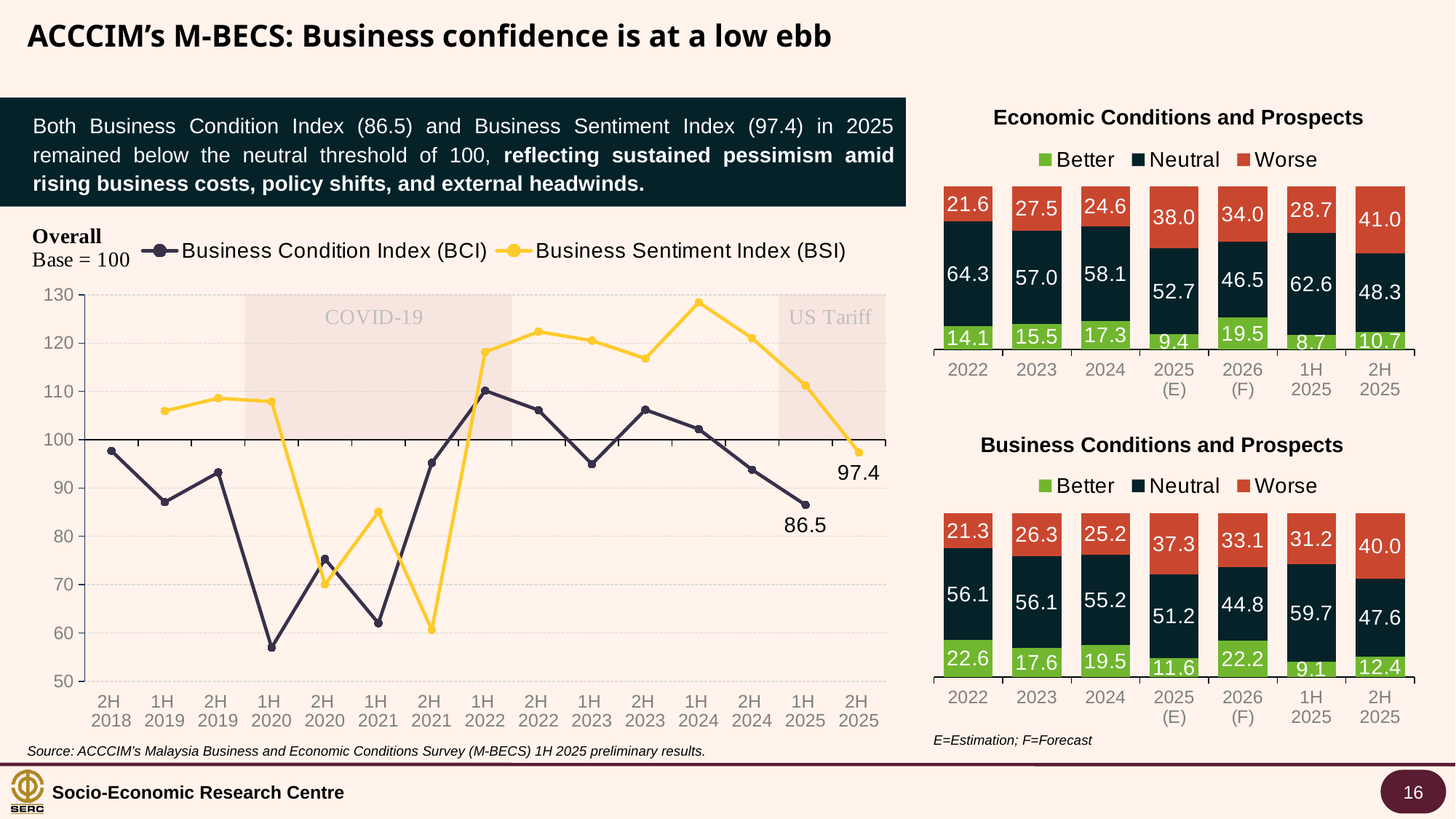
On the Overall line chart, is the BCI value for 1H 2020 greater or less than 60? less On the Economic Conditions and Prospects chart, which period has the lowest Better value? 1H 2025 On the Business Conditions and Prospects chart, what is the Neutral value for 1H 2025? 59.7 On the Overall line chart, what is the Business Sentiment Index (BSI) value for 2H 2025? 97.4 On the Overall line chart, how many series does the legend list? 2 On the Business Conditions and Prospects chart, how many periods are shown on the x axis? 7 On the Business Conditions and Prospects chart, what is the difference between the Worse values for 2H 2025 and 1H 2025? 8.8 On the Economic Conditions and Prospects chart, what is the Worse share for 2H 2025? 41.0 On the Overall line chart, does the BSI rise or fall from 1H 2024 to 2H 2025? fall On the Overall line chart, is the BSI value for 1H 2024 greater or less than 120? greater On the Economic Conditions and Prospects chart, what is the total of the 2022 stacked bar? 100.0